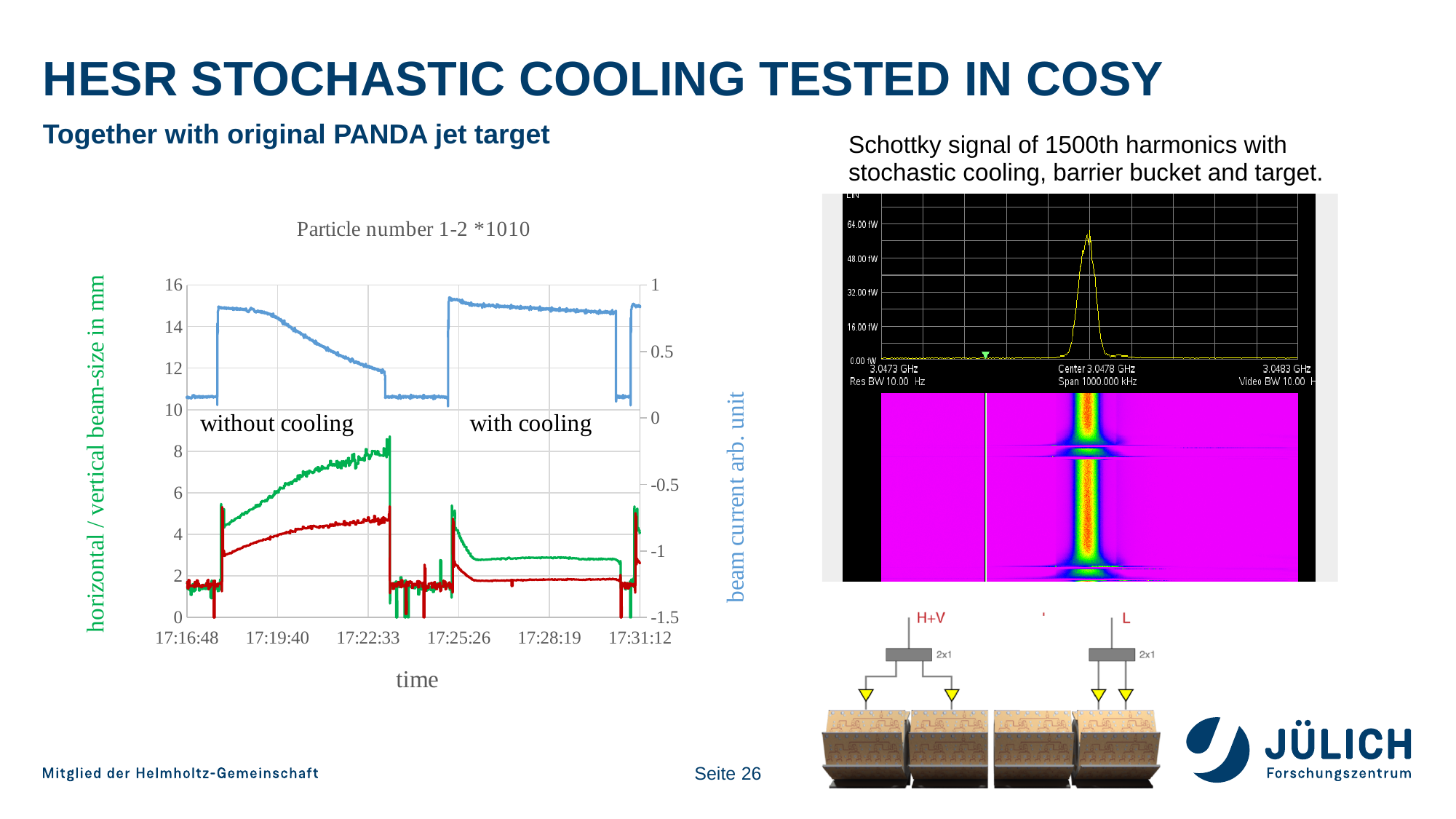
In the chart titled 'Particle number 1-2 *1010', what is the lowest value shown on the right y axis? -1.5 In the chart titled 'Particle number 1-2 *1010', which line reaches a higher beam size in the 'without cooling' period, the green line or the red line? green line In the chart titled 'Particle number 1-2 *1010', is the peak of the green line in the 'without cooling' period greater or less than 6 mm? greater In the chart titled 'Particle number 1-2 *1010', what is the highest value shown on the left y axis? 16 In the chart titled 'Particle number 1-2 *1010', is the plateau of the green line in the 'with cooling' period greater or less than 4 mm? less In the chart titled 'Particle number 1-2 *1010', does the green line rise or fall during the 'without cooling' period? rise In the Schottky signal chart on the right, what is the center frequency shown below the plot? 3.0478 GHz In the chart titled 'Particle number 1-2 *1010', what is the label of the left y axis? horizontal / vertical beam-size in mm In the chart titled 'Particle number 1-2 *1010', how many time ticks are labelled on the x axis? 6 What kind of chart is the chart titled 'Particle number 1-2 *1010'? line chart In the chart titled 'Particle number 1-2 *1010', what is the label of the x axis? time In the chart titled 'Particle number 1-2 *1010', how many lines are plotted? 3